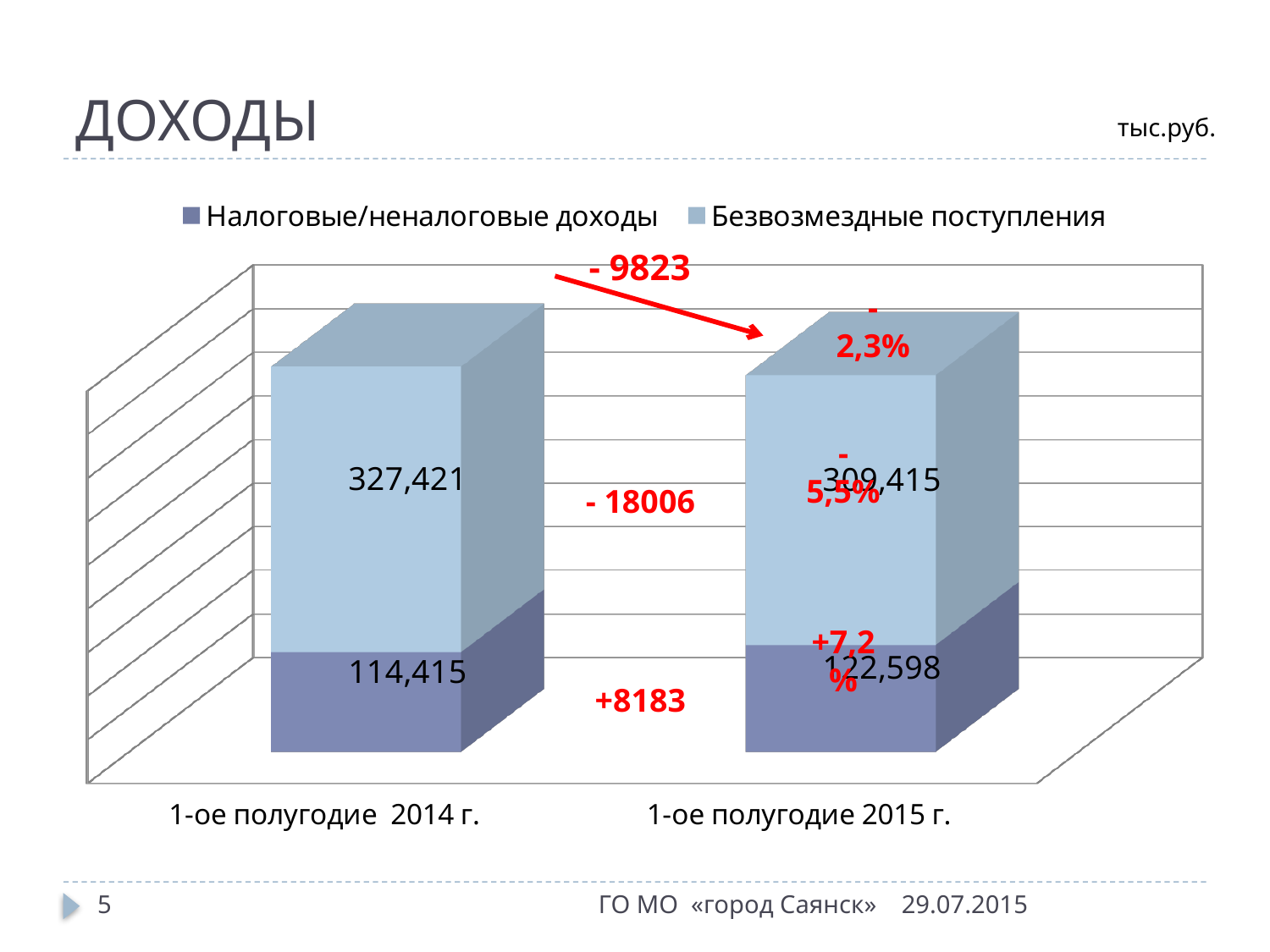
What is the value of Безвозмездные поступления for 1-ое полугодие 2015 г.? 309,415 Which category has the higher value for Безвозмездные поступления? 1-ое полугодие 2014 г. What is the value of Налоговые/неналоговые доходы for 1-ое полугодие 2014 г.? 114,415 What is the value of Налоговые/неналоговые доходы for 1-ое полугодие 2015 г.? 122,598 How many series does the legend list? 2 What unit is indicated for the values on the slide? тыс.руб. What type of chart is shown on the slide? Stacked bar chart How many categories are shown on the x axis? 2 What is the total of the stacked bar for 1-ое полугодие 2014 г.? 441,836 What is the value of Безвозмездные поступления for 1-ое полугодие 2014 г.? 327,421 Is the value of Налоговые/неналоговые доходы larger in 1-ое полугодие 2014 г. or in 1-ое полугодие 2015 г.? 1-ое полугодие 2015 г. Which category has the lower value for Налоговые/неналоговые доходы? 1-ое полугодие 2014 г.